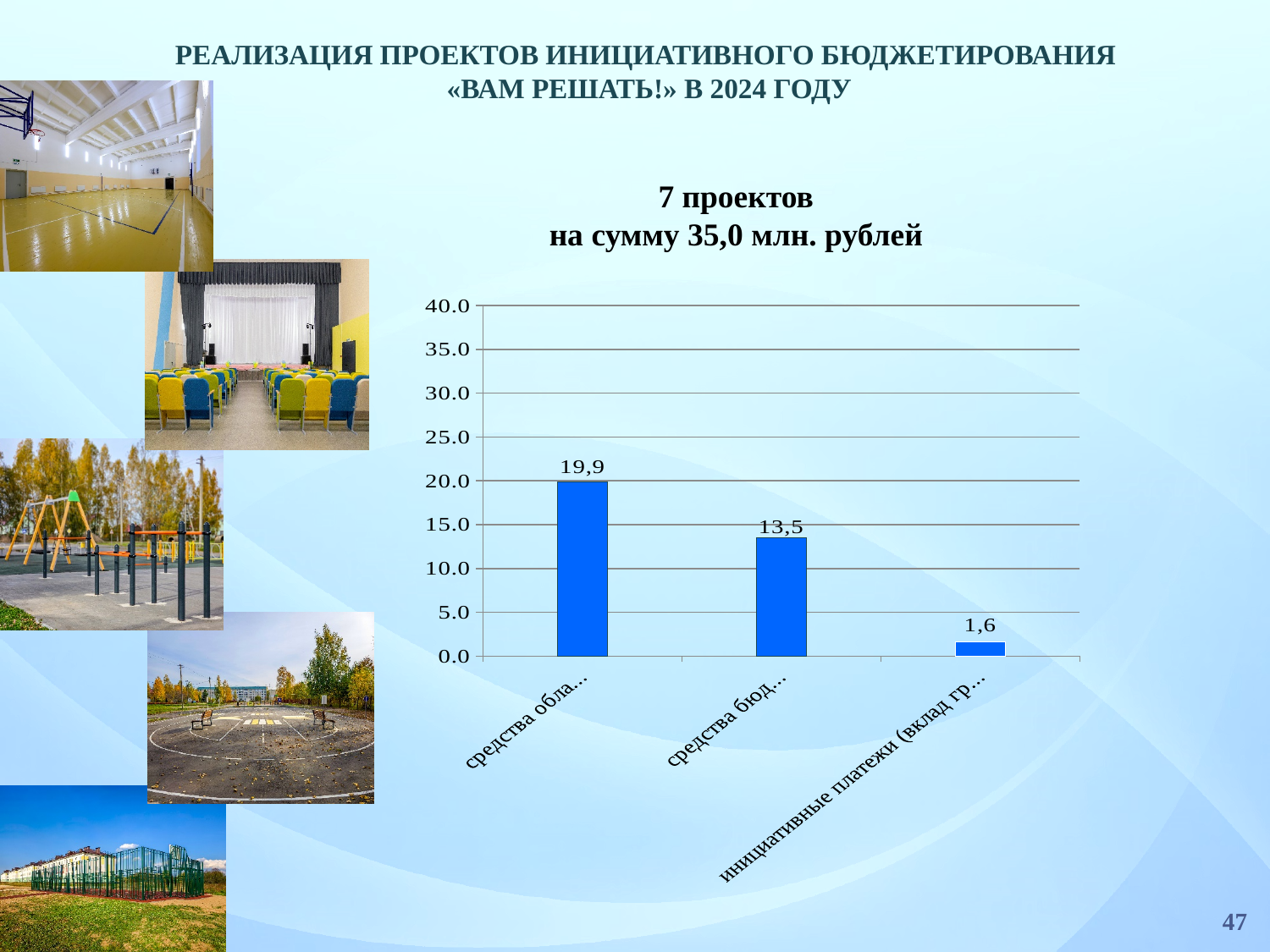
What is the difference between the first bar (19,9) and the second bar (13,5)? 6,4 Which is larger: the value for "средства бюд..." or the value for "инициативные платежи (вклад гр..."? средства бюд... Is the value of the first bar greater or less than 15.0? greater What is the value of the second bar (labelled "средства бюд...")? 13,5 How many bars does the chart contain? 3 Do the bar values rise or fall from left to right along the x axis? fall What is the value of the first bar (labelled "средства обла...")? 19,9 Which bar has the highest value? средства обла... (the first bar) What is the maximum value shown on the vertical axis? 40.0 What is the value of the bar labelled "инициативные платежи (вклад гр..."? 1,6 Which bar has the lowest value? инициативные платежи (вклад гр...) What type of chart is shown on the slide? bar chart